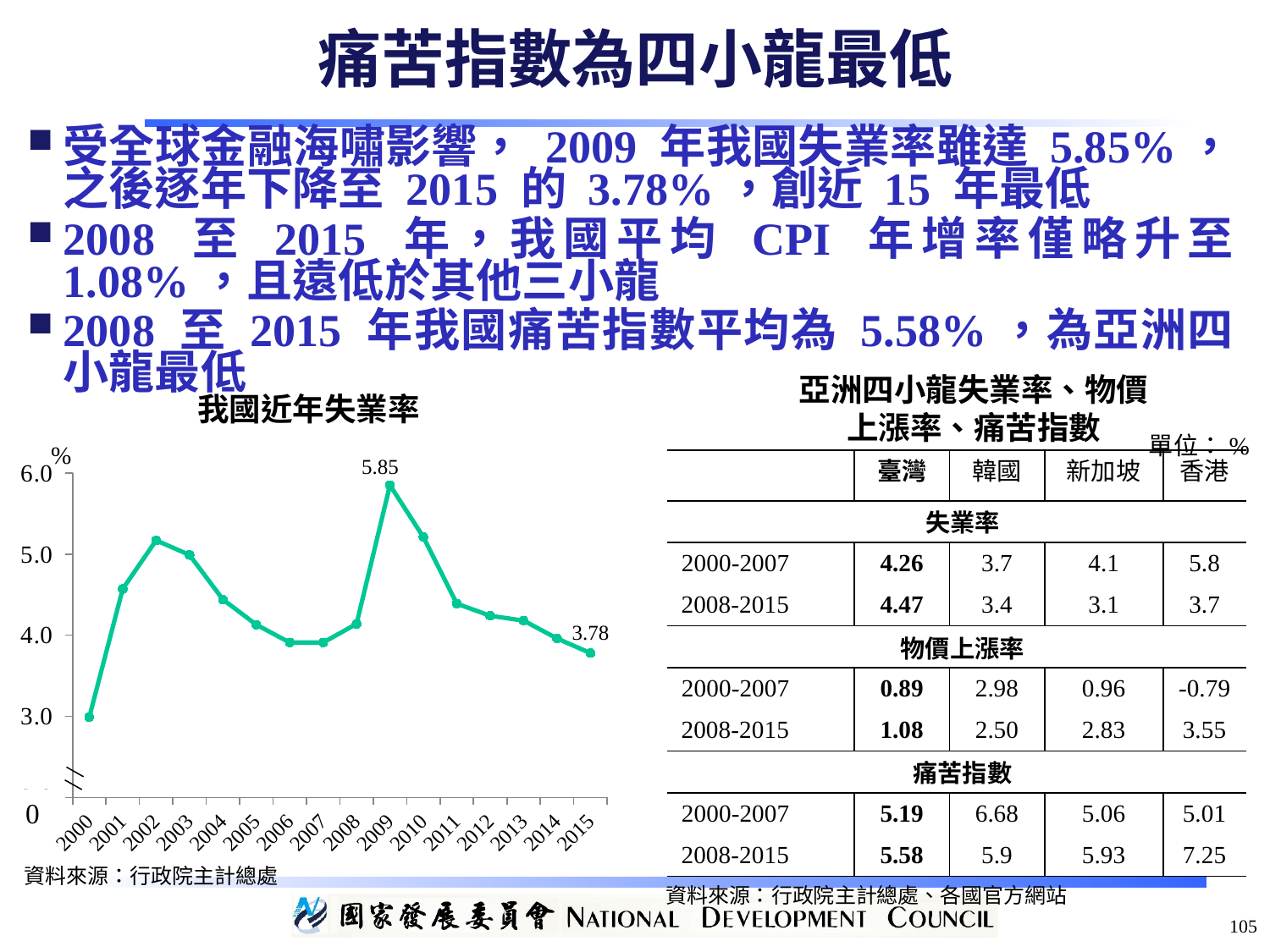
In which year does the 我國近年失業率 chart reach its highest value? 2009 How many years are plotted on the x axis of the 我國近年失業率 chart? 16 What kind of chart is 我國近年失業率? line chart What is the difference between the 2009 and 2015 values in the 我國近年失業率 chart? 2.07 In the 我國近年失業率 chart, is the value for 2000 greater or less than 4.0? less In the 我國近年失業率 chart, is the value for 2004 greater or less than 5.0? less What is the unemployment rate shown for 2009 in the 我國近年失業率 chart? 5.85 What is the unemployment rate shown for 2015 in the 我國近年失業率 chart? 3.78 In the 我國近年失業率 chart, is the value for 2001 greater or less than 4.0? greater In the 我國近年失業率 chart, do the values rise or fall from 2009 to 2015? fall Which year has the higher unemployment rate in the 我國近年失業率 chart, 2009 or 2015? 2009 In which year does the 我國近年失業率 chart show its lowest value? 2000